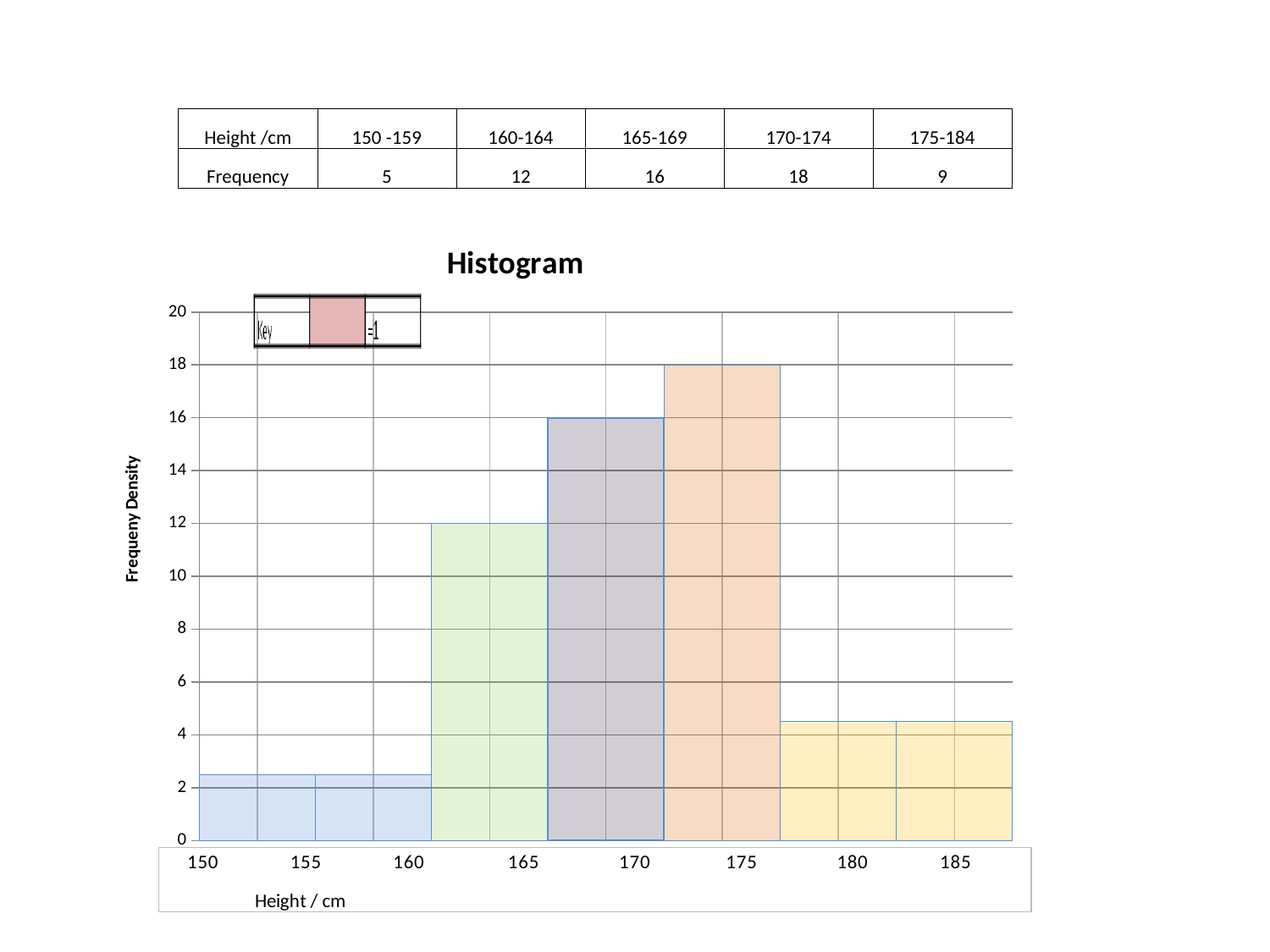
Is the frequency density for the 175-184 group greater or less than 6? less Which height group has the highest frequency density? 170-174 Which has the larger frequency density, the 165-169 group or the 175-184 group? 165-169 What is the frequency density for the 170-174 cm height group? 18 What is the label on the vertical axis of the chart? Frequeny Density What is the frequency density for the 165-169 cm height group? 16 What is the difference in frequency density between the 170-174 group and the 160-164 group? 6 Which height group has the lowest frequency density? 150-159 What is the frequency density for the 160-164 cm height group? 12 What kind of chart is shown on the slide? bar chart (histogram) What is the title of the chart? Histogram